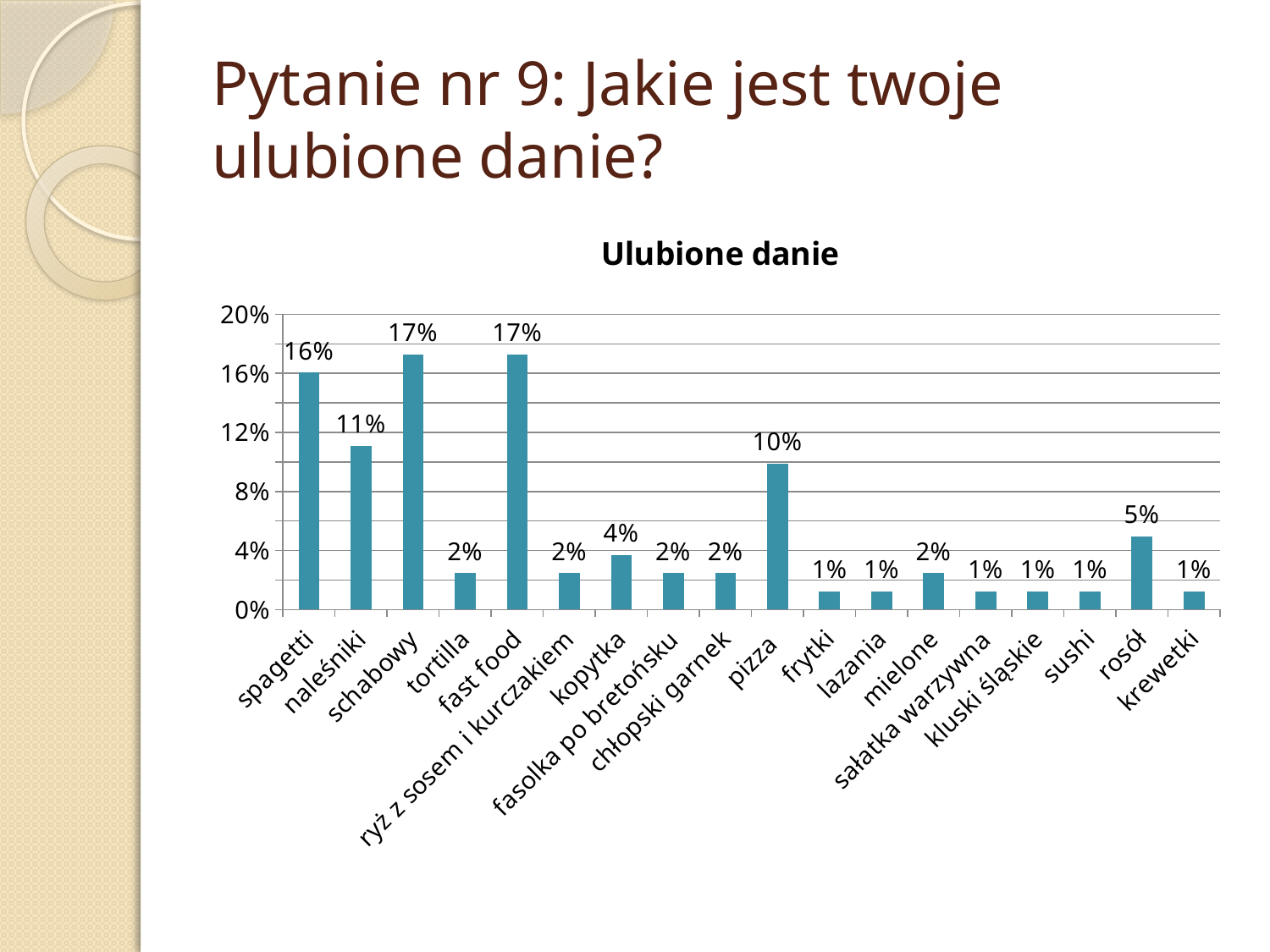
How many dish categories are shown on the x axis? 18 What is the value shown for kopytka? 4% What is the value shown for naleśniki? 11% Which has a higher value, naleśniki or pizza? naleśniki What is the value shown for pizza? 10% What is the difference between the values for spagetti and pizza? 6% What kind of chart is shown on the slide? bar chart What percentage of respondents chose spagetti as their favourite dish? 16% What is the difference between the values for naleśniki and rosół? 6% Which has a higher value, rosół or kopytka? rosół Is the value for pizza greater or less than 8%? greater What is the value shown for rosół? 5%